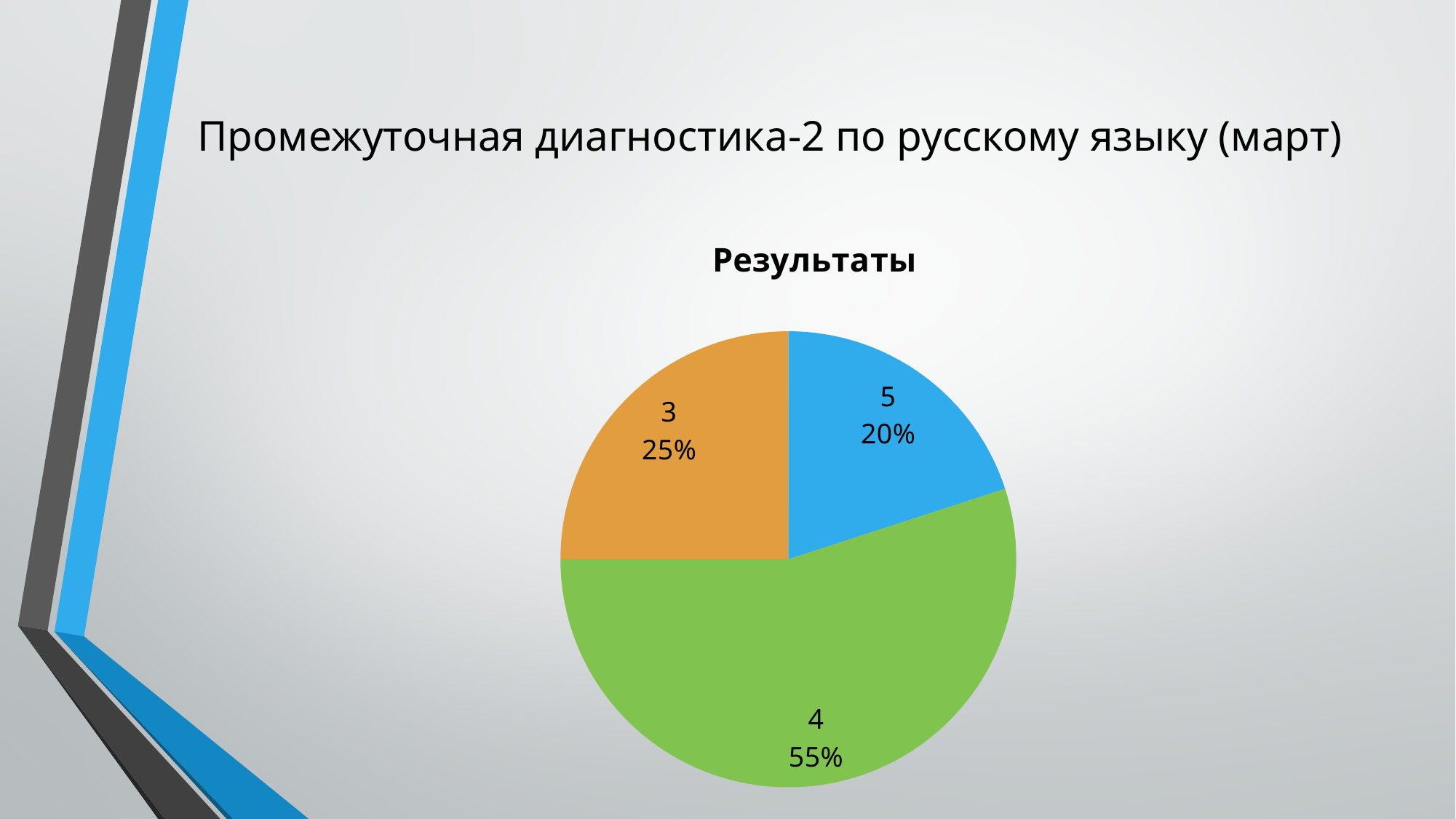
What share of the pie does the slice labelled 5 represent? 20% What share of the pie does the slice labelled 3 represent? 25% How many slices does the pie chart have? 3 What is the title of the chart? Результаты What is the difference in percentage points between the slice labelled 3 and the slice labelled 5? 5% Which slice is larger, the one labelled 3 or the one labelled 5? 3 What is the difference in percentage points between the slice labelled 4 and the slice labelled 3? 30% Which slice is the largest? 4 What colour is the slice labelled 4? green What share of the pie does the slice labelled 4 represent? 55% What type of chart is shown on the slide? pie chart Which slice is the smallest? 5